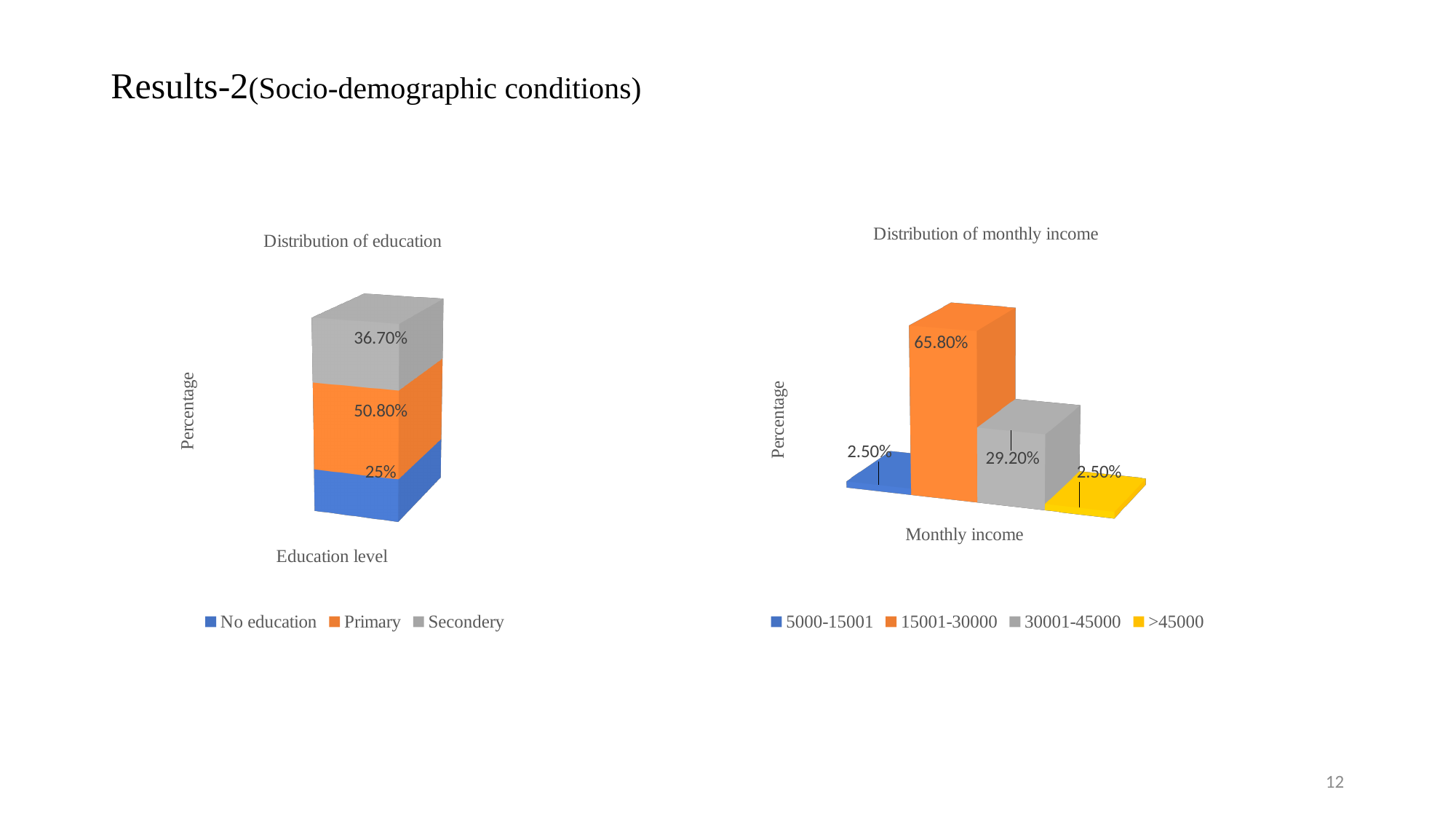
In the 'Distribution of education' chart, what is the value for Primary? 50.80% In the 'Distribution of monthly income' chart, what is the value for 30001-45000? 29.20% In the 'Distribution of education' chart, which education level has the highest value? Primary In the 'Distribution of monthly income' chart, what is the value for 15001-30000? 65.80% In the 'Distribution of monthly income' chart, which income group has the highest value? 15001-30000 In the 'Distribution of education' chart, what is the difference between the Primary and Secondery values? 14.10% In the 'Distribution of monthly income' chart, how many series does the legend list? 4 In the 'Distribution of monthly income' chart, what is the difference between the 15001-30000 and 30001-45000 values? 36.60% In the 'Distribution of education' chart, how many series does the legend list? 3 What kind of chart is the 'Distribution of monthly income' chart? Bar chart In the 'Distribution of education' chart, what is the value for Secondery? 36.70% In the 'Distribution of education' chart, what is the value for No education? 25%